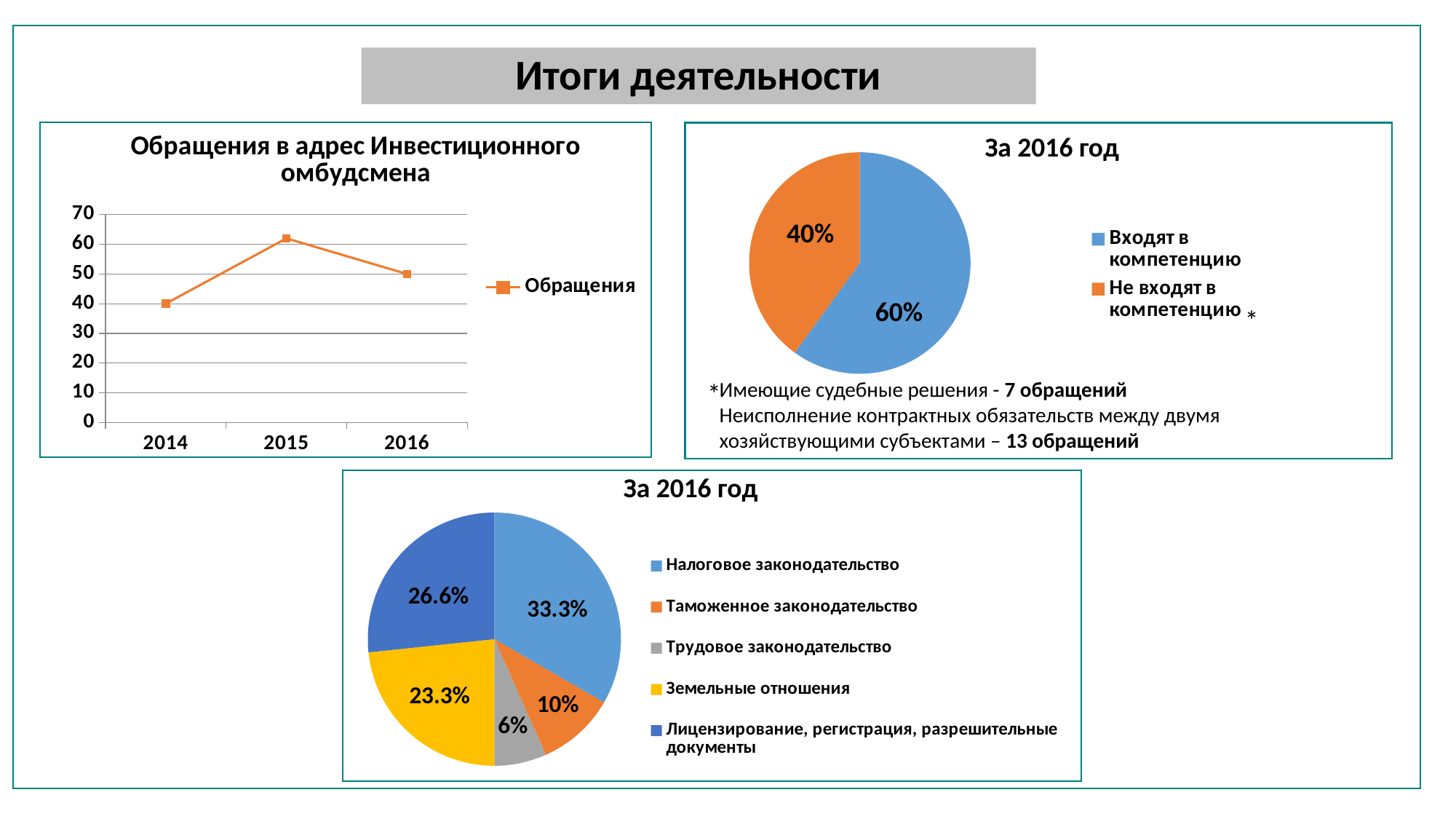
In the chart 'Обращения в адрес Инвестиционного омбудсмена', which year has the highest value? 2015 In the top-right pie chart 'За 2016 год', what share is 'Входят в компетенцию'? 60% In the chart 'Обращения в адрес Инвестиционного омбудсмена', how many years are plotted on the x axis? 3 In the top-right pie chart 'За 2016 год', what share is 'Не входят в компетенцию'? 40% In the chart 'Обращения в адрес Инвестиционного омбудсмена', do the values rise or fall from 2015 to 2016? Fall In the bottom pie chart 'За 2016 год', which category has the smallest share? Трудовое законодательство What type of chart is 'Обращения в адрес Инвестиционного омбудсмена'? Line chart In the bottom pie chart 'За 2016 год', how many categories does the legend list? 5 In the chart 'Обращения в адрес Инвестиционного омбудсмена', what is the value for 2014? 40 In the chart 'Обращения в адрес Инвестиционного омбудсмена', is the value for 2015 greater or less than 50? greater In the chart 'Обращения в адрес Инвестиционного омбудсмена', what is the value for 2016? 50 In the bottom pie chart 'За 2016 год', what share is 'Земельные отношения'? 23.3%